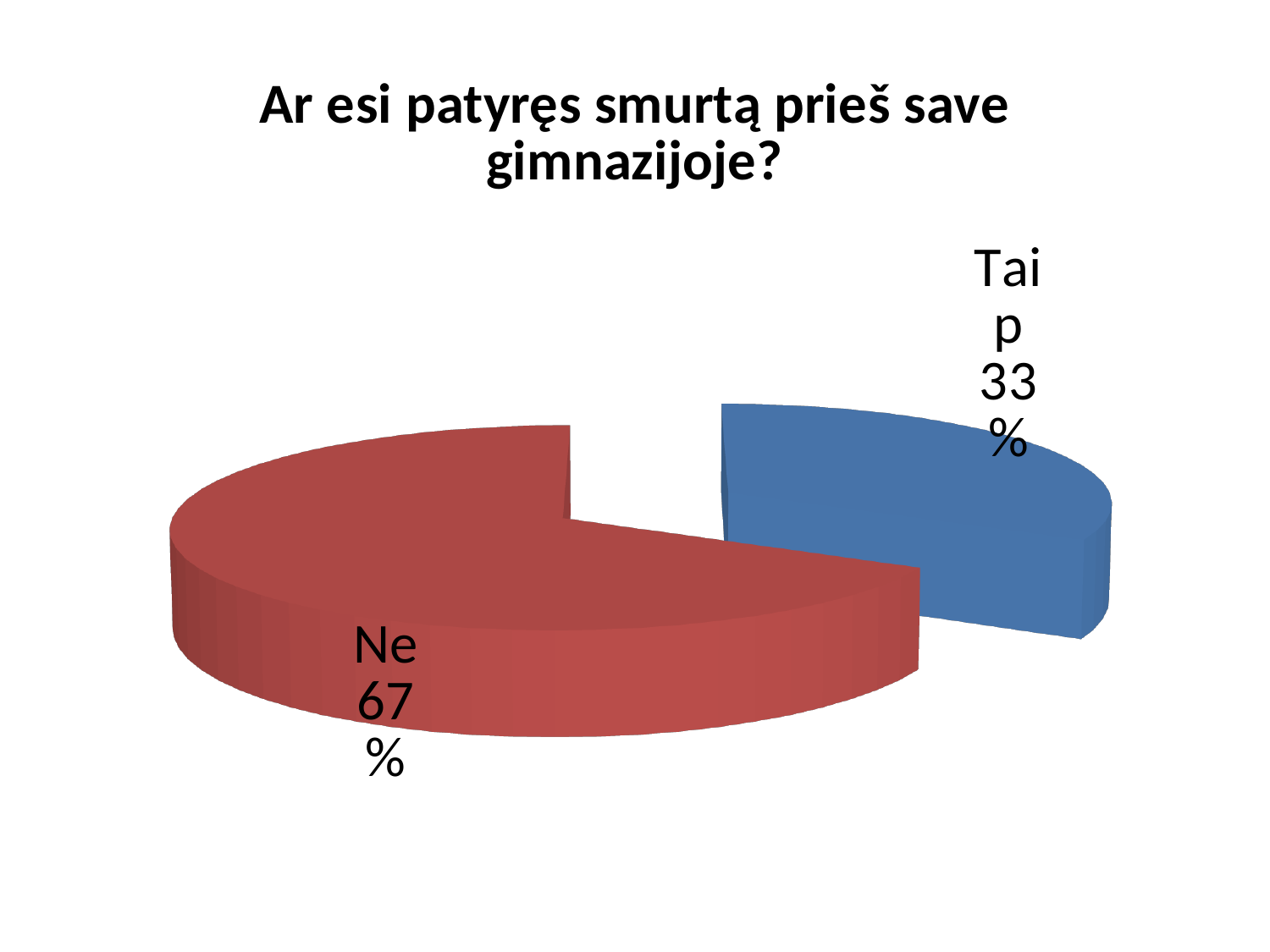
What share of the pie does the "Taip" slice represent? 33% What share of the pie does the "Ne" slice represent? 67% What kind of chart is shown on the slide? Pie chart Which slice is the largest in the pie chart? Ne What is the title of the chart? Ar esi patyręs smurtą prieš save gimnazijoje? Which slice is the smallest in the pie chart? Taip Which slice is larger, "Taip" or "Ne"? Ne What colour is the "Taip" slice? Blue How many slices does the pie chart have? 2 What is the difference in percentage points between the "Ne" and "Taip" slices? 34